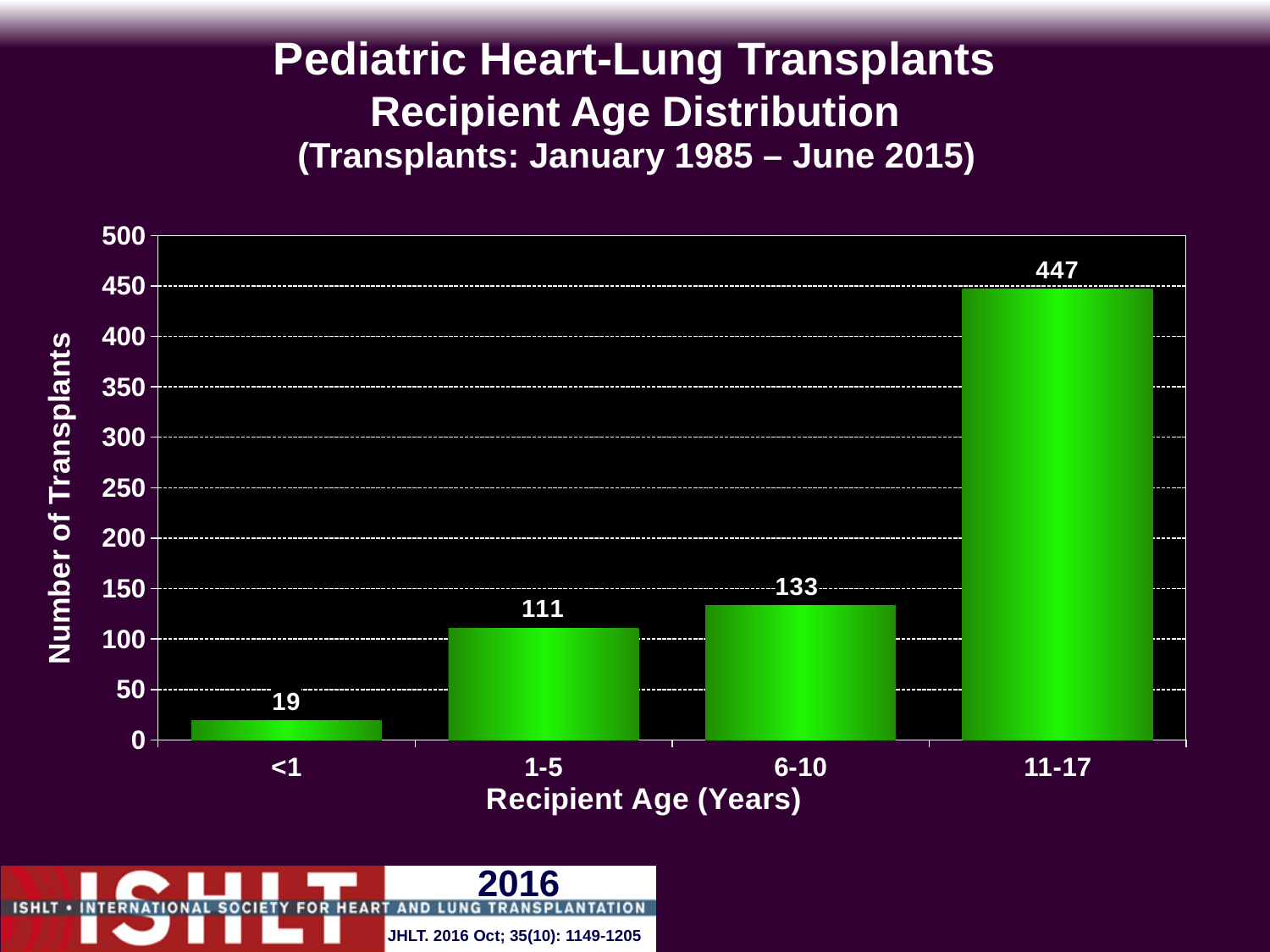
How many transplants were performed for recipients aged 11-17? 447 Which recipient age group has the highest number of transplants? 11-17 What is the number of transplants for recipients aged 6-10? 133 How many recipient age groups are shown on the x axis? 4 What is the number of transplants for the <1 age group? 19 Which age group has more transplants, 1-5 or 6-10? 6-10 What is the difference in number of transplants between the 11-17 and 6-10 age groups? 314 Is the number of transplants for the 1-5 age group greater or less than 100? greater What is the difference in number of transplants between the 1-5 and <1 age groups? 92 What kind of chart is shown on the slide? Bar chart Do the number of transplants rise or fall as recipient age increases along the x axis? Rise Which recipient age group has the lowest number of transplants? <1